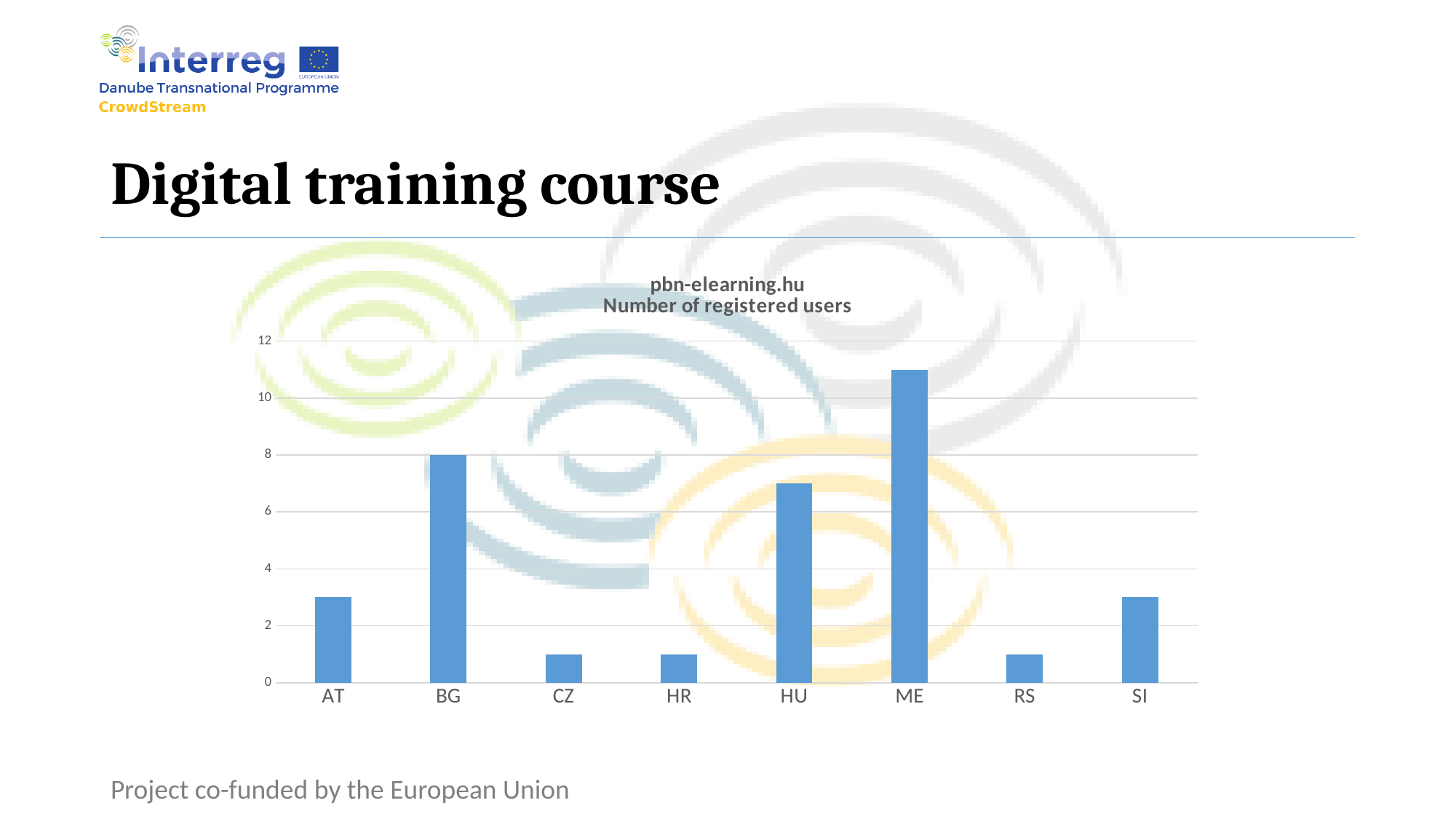
Is the value for CZ greater or less than 2? less Which has more registered users, AT or HR? AT How many countries are shown on the x axis of the chart? 8 Which has more registered users, BG or HU? BG Which has more registered users, BG or ME? ME Which country has the highest number of registered users? ME Is the value for AT greater or less than 4? less What is the number of registered users for BG? 8 What is the title of the chart? pbn-elearning.hu Number of registered users Is the value for HU greater or less than 6? greater What kind of chart is shown on the slide? bar chart